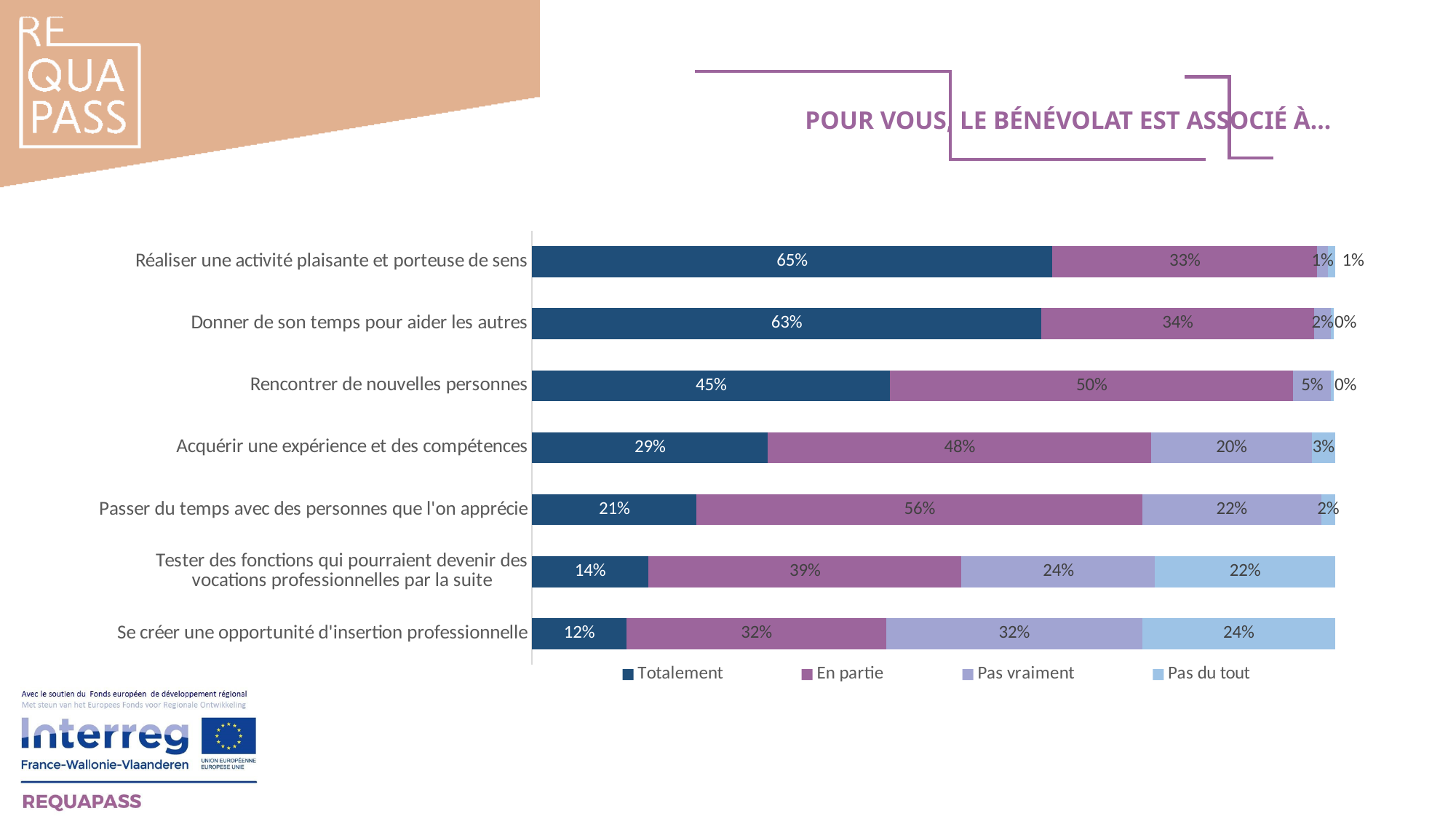
Which category has the lowest 'Totalement' value? Se créer une opportunité d'insertion professionnelle How many series does the legend list? 4 Which category has the highest 'Totalement' value? Réaliser une activité plaisante et porteuse de sens What is the 'Totalement' value for 'Réaliser une activité plaisante et porteuse de sens'? 65% Which is larger: the 'Totalement' value for 'Donner de son temps pour aider les autres' or for 'Rencontrer de nouvelles personnes'? Donner de son temps pour aider les autres What is the difference between the 'En partie' values for 'Passer du temps avec des personnes que l'on apprécie' and 'Acquérir une expérience et des compétences'? 8% What is the 'Pas du tout' value for 'Se créer une opportunité d'insertion professionnelle'? 24% What is the 'Pas vraiment' value for 'Tester des fonctions qui pourraient devenir des vocations professionnelles par la suite'? 24% What is the title of the chart? POUR VOUS, LE BÉNÉVOLAT EST ASSOCIÉ À… What type of chart is shown on the slide? Stacked bar chart What is the 'En partie' value for 'Rencontrer de nouvelles personnes'? 50% How many categories are plotted in the chart? 7